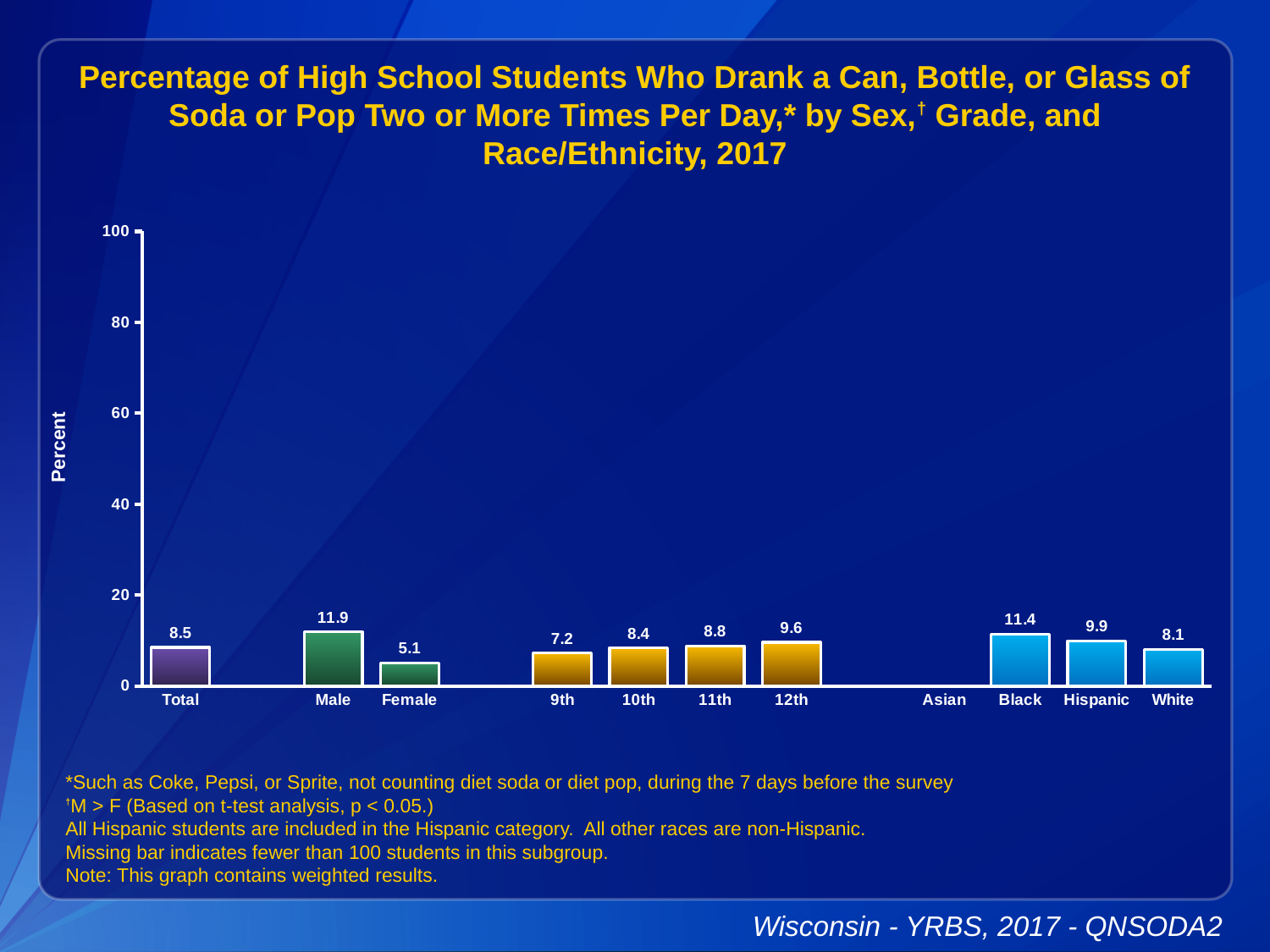
What kind of chart is shown? bar chart What is the value for 12th grade? 9.6 Which is larger, the value for Hispanic or the value for White? Hispanic How many categories are labeled on the x axis? 11 Which category has the lowest value among those with a bar shown? Female What is the difference between the Male and Female values? 6.8 Do the values rise or fall from 9th grade to 12th grade? rise Is the value for Total greater or less than 20? less What is the value for Black students? 11.4 What is the value for Male? 11.9 Which category has the highest value? Male What is the value for Female? 5.1